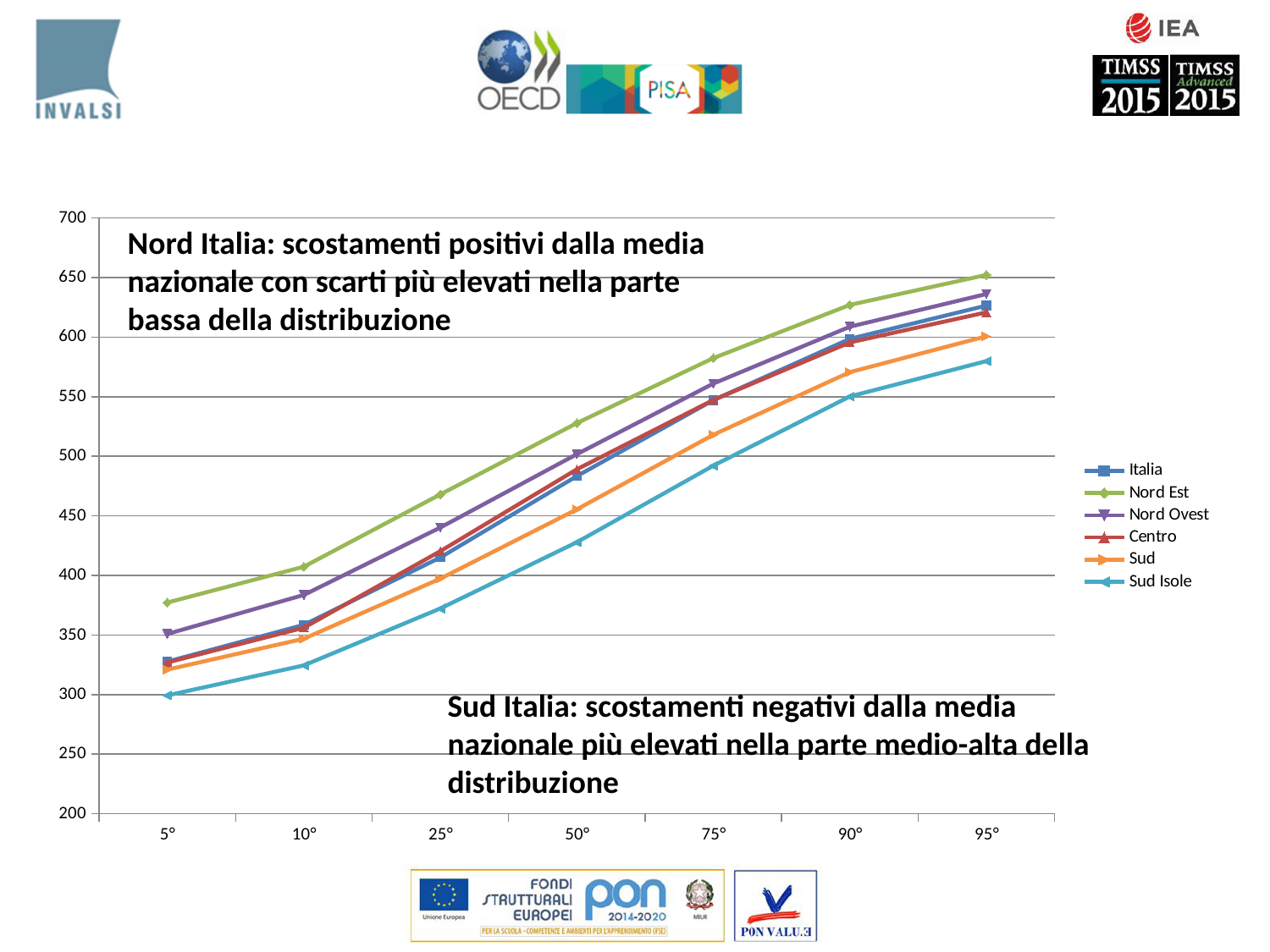
What kind of chart is shown on the slide? line chart Do the values for Italia rise or fall from the 5° to the 95° percentile? rise How many percentile points are shown along the x axis? 7 Is the value for Sud Isole at the 95° percentile greater or less than 600? less How many series does the legend list? 6 Is the value for Nord Est at the 50° percentile greater or less than 500? greater Which series has the highest value at the 95° percentile? Nord Est At the 50° percentile, which is larger: Nord Ovest or Sud? Nord Ovest Which series has the lowest value at the 5° percentile? Sud Isole Which series is drawn in green in the legend? Nord Est Is the value for Italia at the 25° percentile greater or less than 450? less